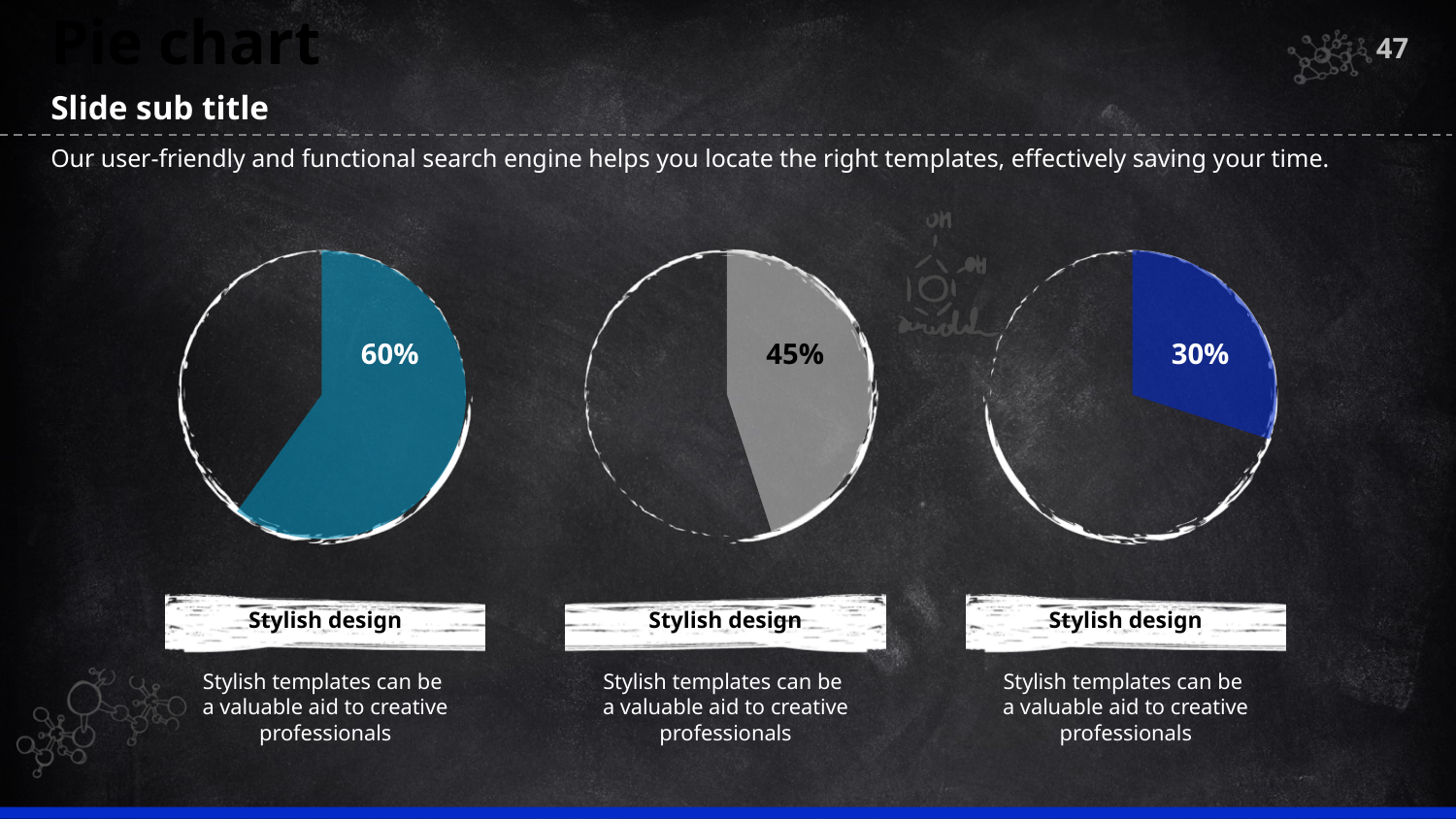
What colour is the filled slice of the middle pie chart? Grey What percentage is shown on the left pie chart? 60% What percentage is shown on the middle pie chart? 45% What colour is the filled slice of the right pie chart? Blue What is the difference between the percentage on the left pie chart and the percentage on the right pie chart? 30% Is the percentage on the left pie chart larger or smaller than the percentage on the middle pie chart? Larger Which pie chart shows the largest percentage: the left, middle, or right one? Left Which pie chart shows the smallest percentage: the left, middle, or right one? Right What kind of chart is used on this slide? Pie chart How many pie charts are on the slide? 3 What is the difference between the percentage on the middle pie chart and the percentage on the right pie chart? 15% What percentage is shown on the right pie chart? 30%